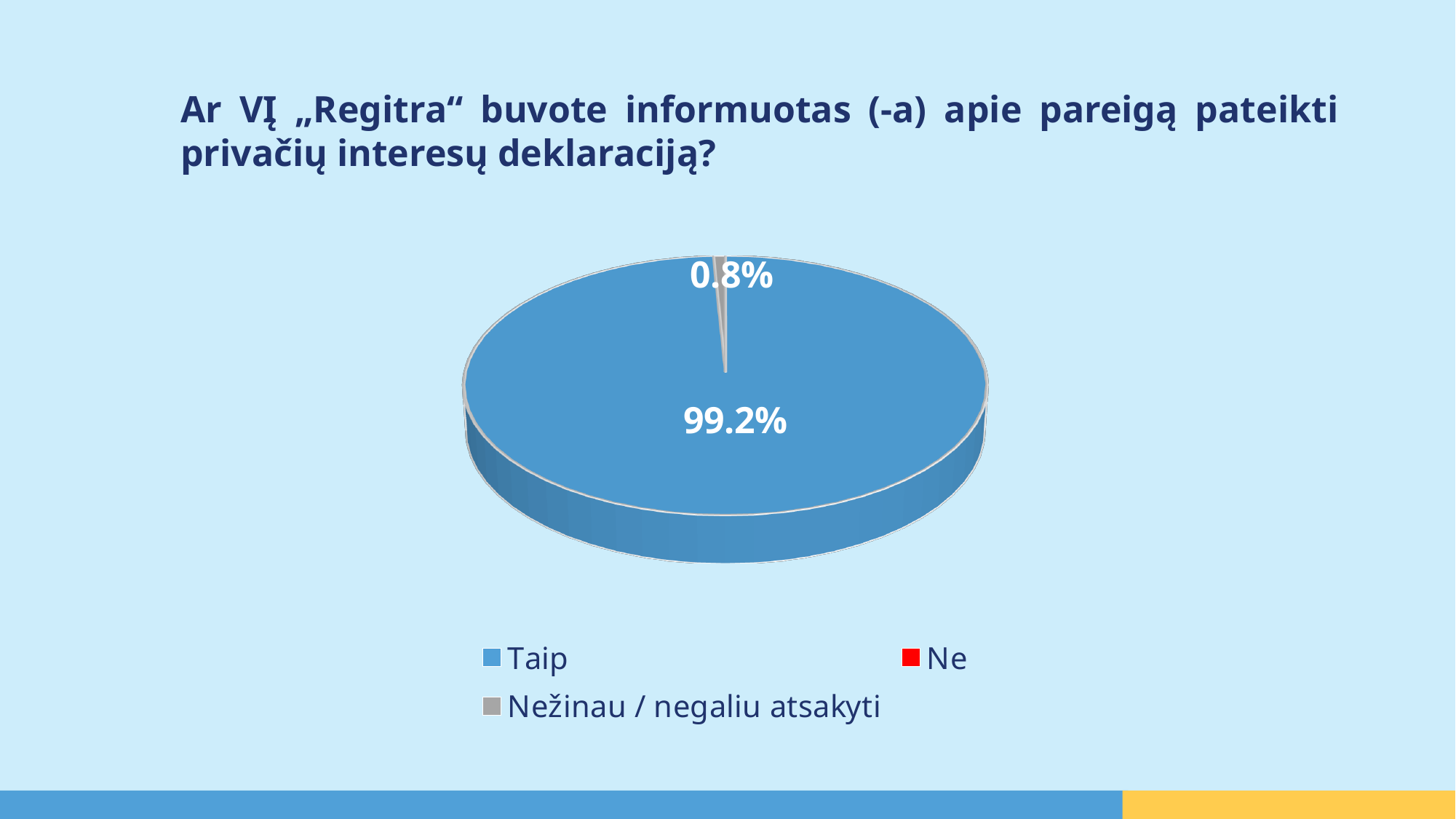
Is the share for "Taip" larger than the share for "Nežinau / negaliu atsakyti"? Yes Which legend entry is shown in red? Ne Which of the two labelled slices is smaller, "Taip" or "Nežinau / negaliu atsakyti"? Nežinau / negaliu atsakyti What share of the pie is labelled for "Taip"? 99.2% What kind of chart is shown on the slide? pie chart How many entries does the legend list? 3 What is the difference between the "Taip" share and the "Nežinau / negaliu atsakyti" share? 98.4% Which category has the largest slice of the pie? Taip What colour is the "Taip" slice? blue Is the share for "Taip" greater or less than 50%? greater What share of the pie is labelled for "Nežinau / negaliu atsakyti"? 0.8%